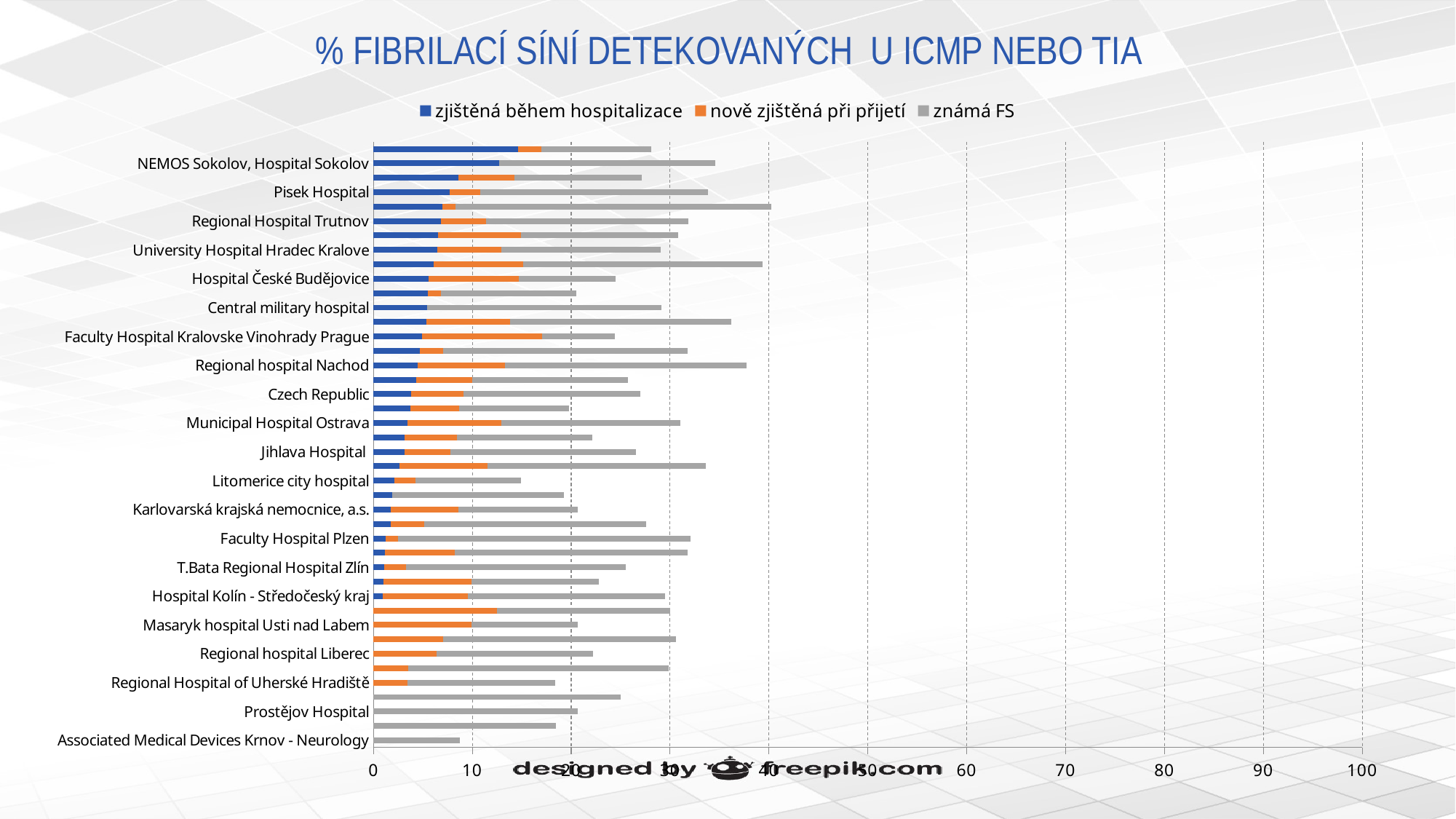
Is the total bar length for Regional Hospital of Uherské Hradiště greater or less than 20? less Which has the longer total bar, NEMOS Sokolov, Hospital Sokolov or Prostějov Hospital? NEMOS Sokolov, Hospital Sokolov What is the title of the chart? % FIBRILACÍ SÍNÍ DETEKOVANÝCH U ICMP NEBO TIA Which series is shown in orange in the legend? nově zjištěná při přijetí Is the total bar length for Regional hospital Nachod greater or less than 30? greater Is the total bar length for Hospital České Budějovice greater or less than 20? greater What kind of chart is shown on the slide? Stacked horizontal bar chart Which has the longer total bar, Regional hospital Nachod or Litomerice city hospital? Regional hospital Nachod How many series does the legend list? 3